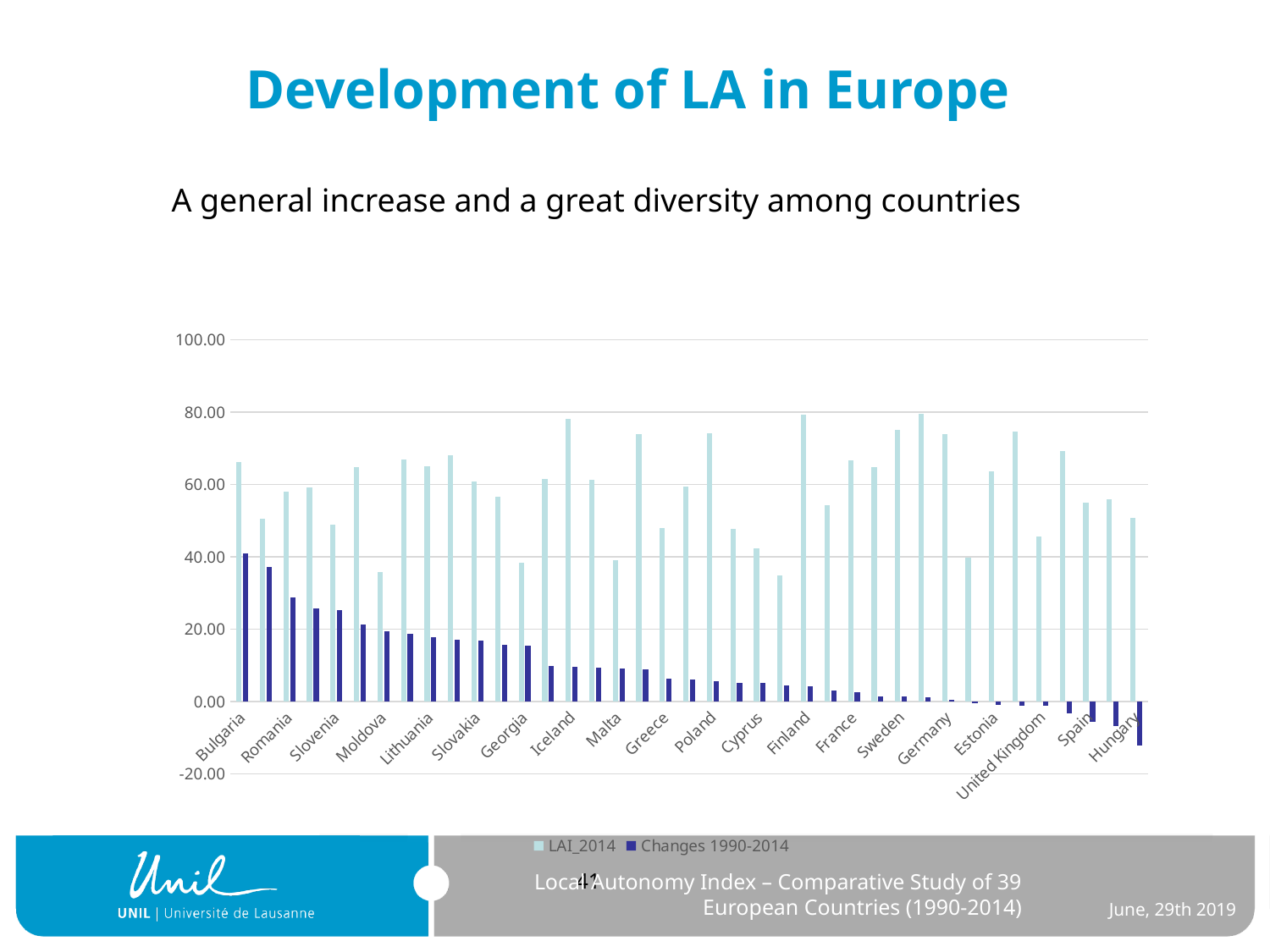
What are the two series named in the legend? LAI_2014 and Changes 1990-2014 Is the Changes 1990-2014 value for Bulgaria greater or less than 20? greater Is the LAI_2014 value for Iceland greater or less than 60? greater Which series is shown in dark blue? Changes 1990-2014 How many series does the legend list? 2 Which is larger, the Changes 1990-2014 value for Bulgaria or for Romania? Bulgaria Do the Changes 1990-2014 values rise or fall from left to right along the x axis? fall Is the Changes 1990-2014 value for Hungary greater or less than 0? less Which country has the highest value for Changes 1990-2014? Bulgaria What kind of chart is shown on the slide? bar chart Which country has the lowest value for Changes 1990-2014? Hungary